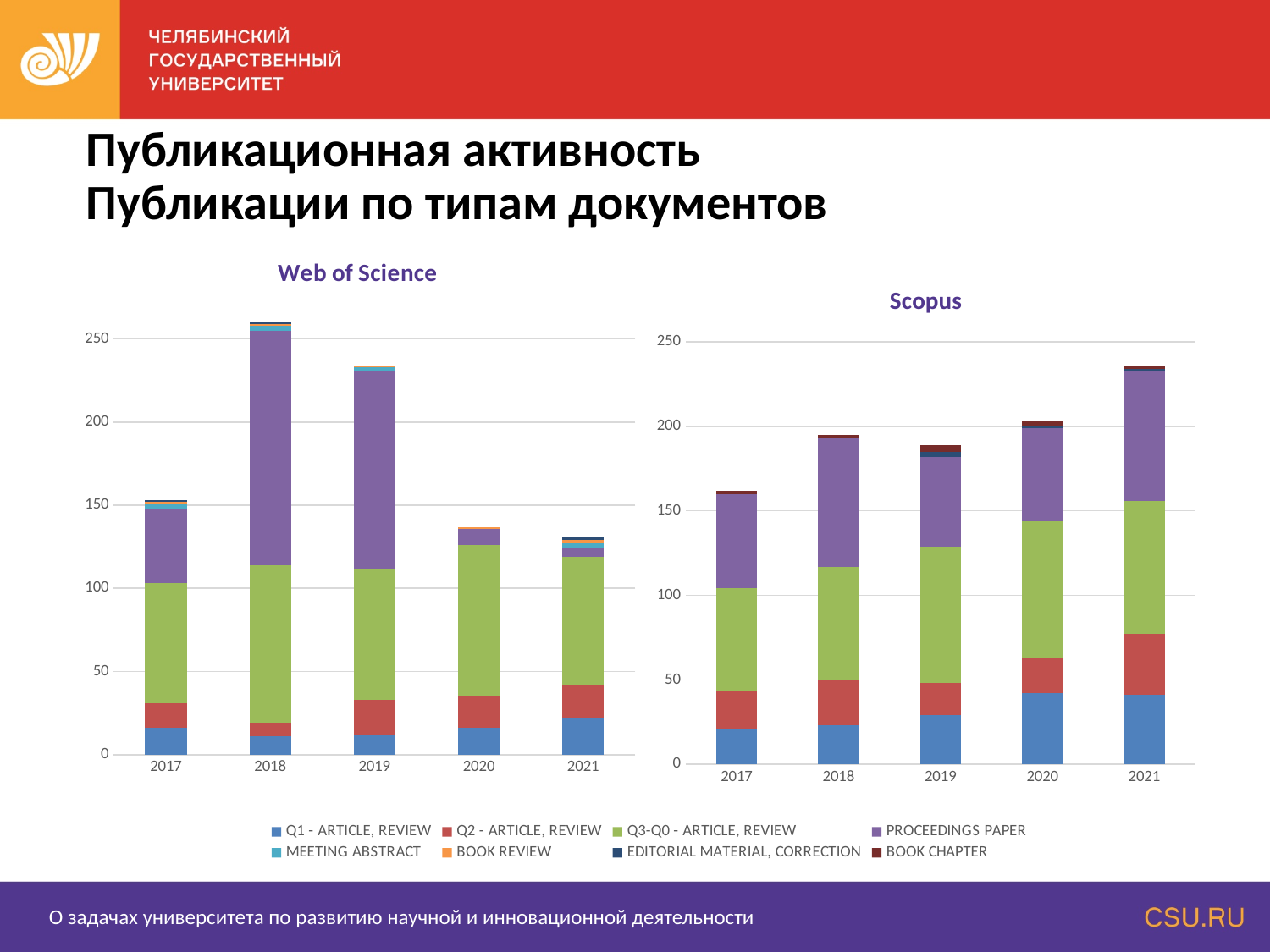
In the Scopus chart, is the total for 2021 greater or less than 200? greater What kind of chart is the Web of Science chart? stacked bar chart How many years are shown on the x axis of the Scopus chart? 5 How many series does the legend list? 8 In the Scopus chart, which year has the lowest total bar? 2017 In the Scopus chart, is the total for 2017 greater or less than 150? greater In the Web of Science chart, which year has the lowest total bar? 2021 In the Web of Science chart, which year has the highest total bar? 2018 In the Web of Science chart, is the total for 2019 greater or less than 200? greater In the Web of Science chart, which year has the larger total bar, 2018 or 2019? 2018 In the Scopus chart, which year has the highest total bar? 2021